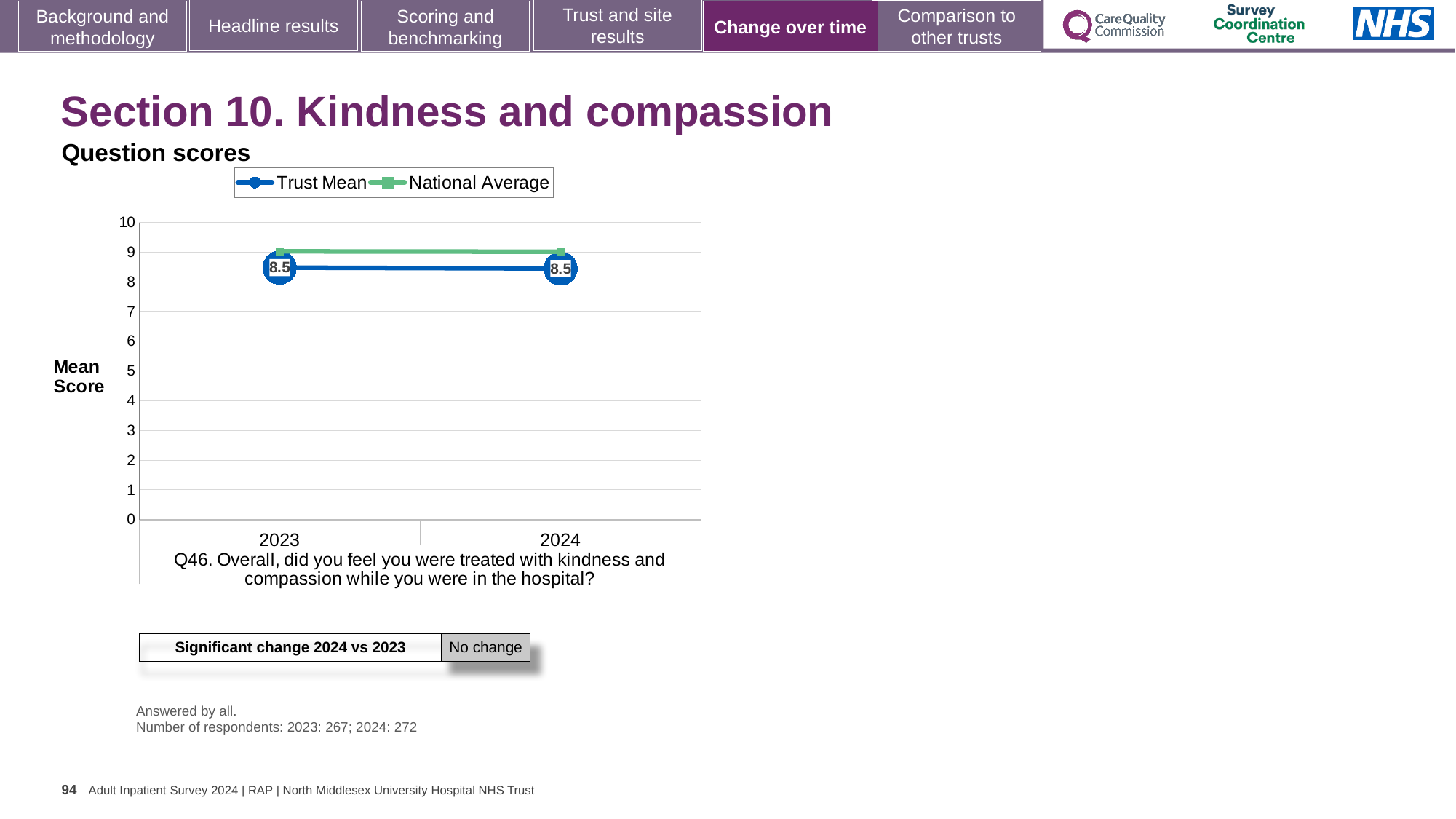
What is the Trust Mean score for 2024? 8.5 What kind of chart is shown on the slide? line chart Is the National Average value for 2023 greater or less than 10? less How many years are plotted on the x axis? 2 What is the label of the y axis? Mean Score Is the National Average value for 2024 greater or less than 8? greater Which series is shown in green in the legend? National Average What is the difference between the Trust Mean score in 2024 and in 2023? 0 What is the Trust Mean score for 2023? 8.5 How many series does the legend list? 2 Does the Trust Mean rise, fall or stay the same from 2023 to 2024? stays the same In 2023, which is higher: the Trust Mean or the National Average? National Average